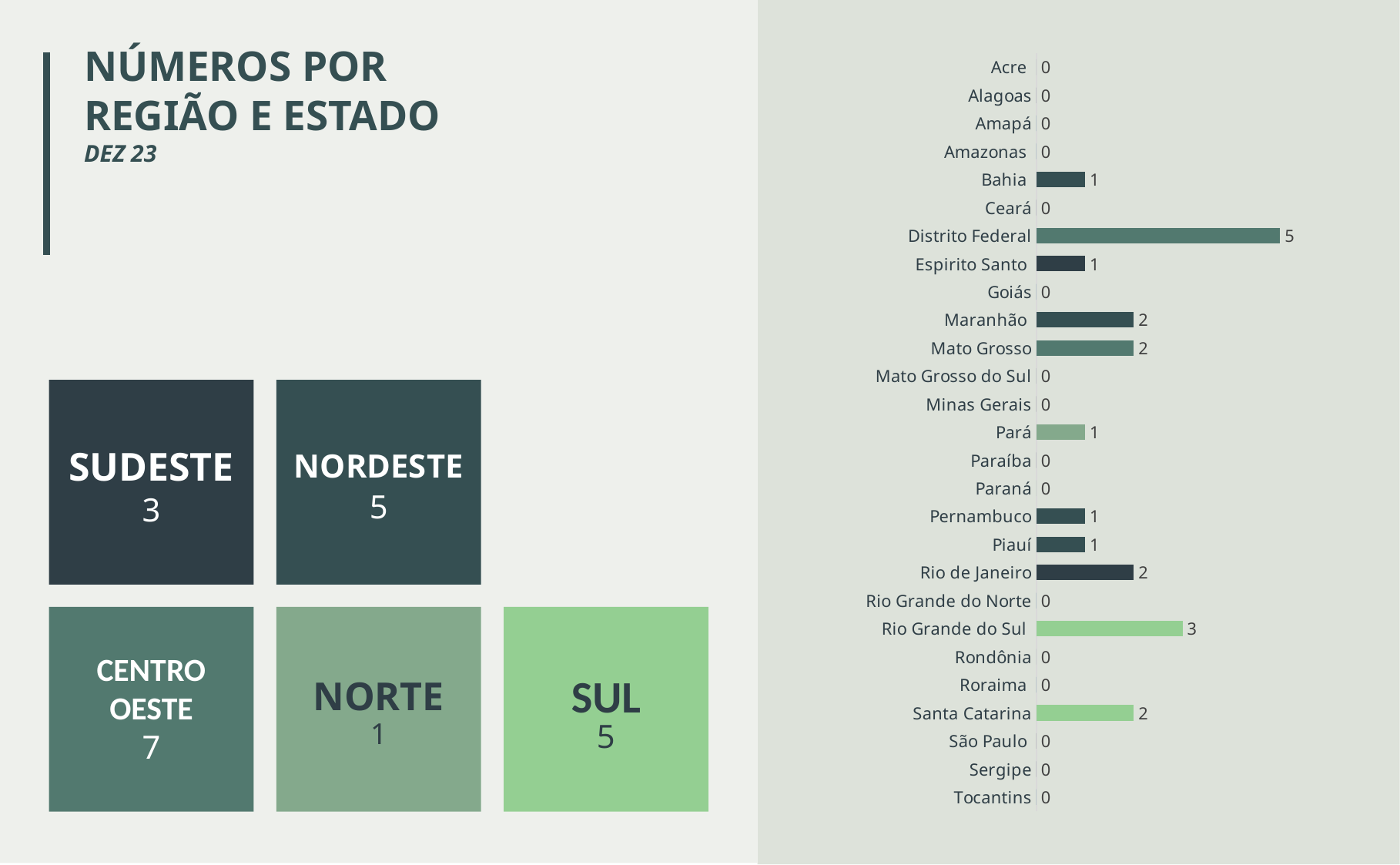
In the bar chart, what is the value for Bahia? 1 In the bar chart, which has a larger value, Rio Grande do Sul or Maranhão? Rio Grande do Sul In the bar chart, what is the value for Distrito Federal? 5 In the bar chart, which has a larger value, Rio de Janeiro or Pernambuco? Rio de Janeiro What type of chart is shown on the right side of the slide? bar chart In the bar chart, what is the value for Rio Grande do Sul? 3 What is the title of the slide containing the bar chart? NÚMEROS POR REGIÃO E ESTADO In the bar chart, what is the value for Santa Catarina? 2 In the bar chart, what is the value for São Paulo? 0 How many states are listed in the bar chart? 27 In the bar chart, what is the difference between the values for Distrito Federal and Rio Grande do Sul? 2 Which state has the highest value in the bar chart? Distrito Federal